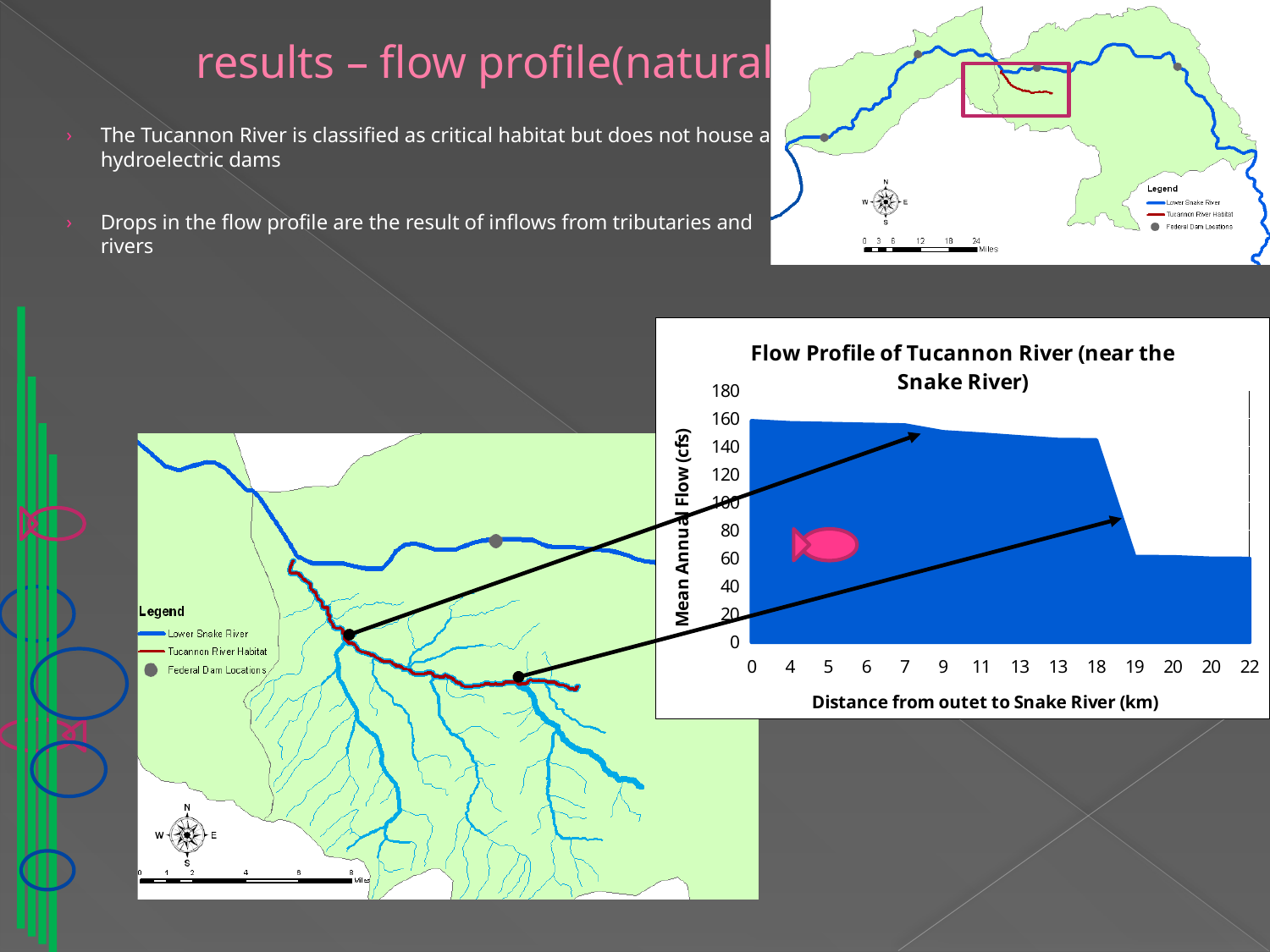
Is the mean annual flow at 7 km greater or less than 120? greater What is the label of the y axis on the flow profile chart? Mean Annual Flow (cfs) Which has the larger mean annual flow, 4 km or 20 km from the outlet? 4 km What is the highest value shown on the y axis of the flow profile chart? 180 Does the mean annual flow rise or fall as distance from the outlet increases along the x axis? fall Is the mean annual flow at 22 km greater or less than 100? less What is the title of the chart on the slide? Flow Profile of Tucannon River (near the Snake River) Which has the larger mean annual flow, 9 km or 22 km from the outlet? 9 km Is the mean annual flow at 0 km greater or less than 140? greater What kind of chart is the Flow Profile of Tucannon River chart? area chart